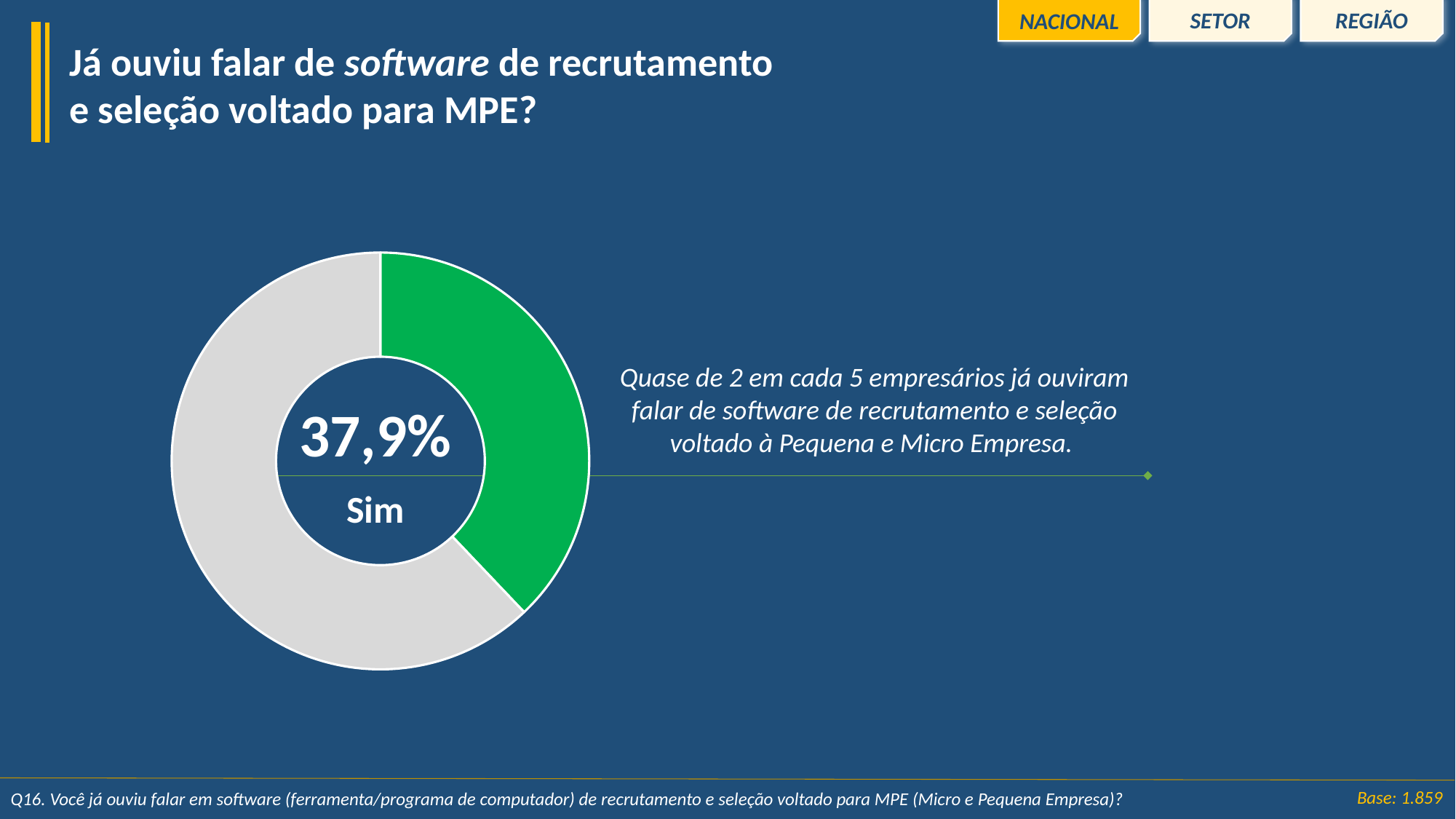
How many slices does the donut chart have? 2 What percentage of respondents answered "Sim" in the donut chart? 37,9% What kind of chart is shown on the slide? Donut (pie) chart What is the base (number of respondents) shown on the slide? 1.859 Which label is printed in the centre of the donut chart below the percentage? Sim What colour is the "Sim" slice of the donut chart? Green What share of the donut chart does the "Sim" slice represent? 37,9% Which slice of the donut chart is larger, the green "Sim" slice or the grey slice? The grey slice Is the share for "Sim" greater or less than 50%? less